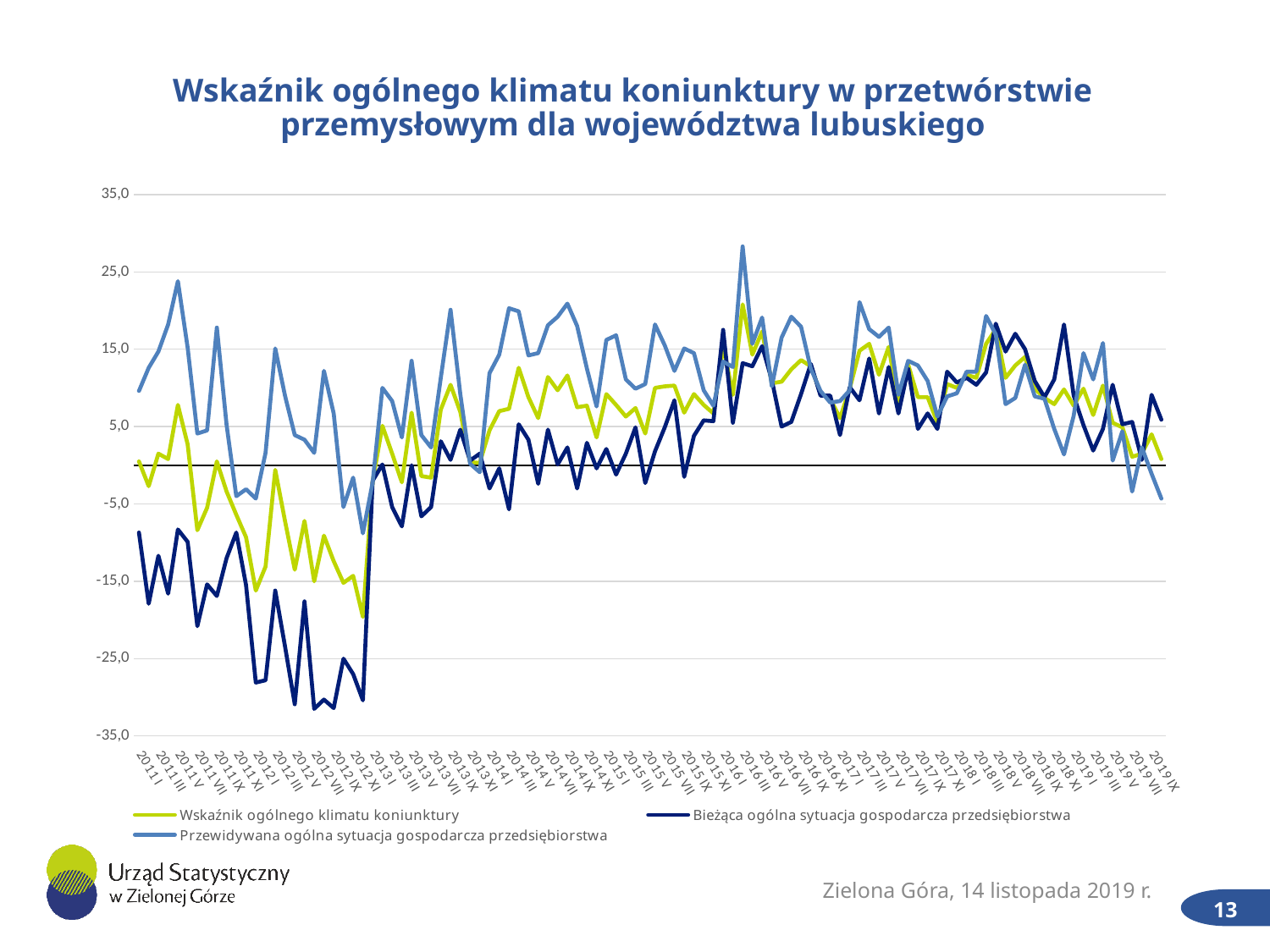
Which series reaches the lowest value anywhere on the chart? Bieżąca ogólna sytuacja gospodarcza przedsiębiorstwa What kind of chart is shown on the slide? line chart Is the value of 'Bieżąca ogólna sytuacja gospodarcza przedsiębiorstwa' at 2012 III greater or less than -25? greater Does 'Bieżąca ogólna sytuacja gospodarcza przedsiębiorstwa' rise or fall between 2012 XI and 2013 I? rise Which series reaches the highest value anywhere on the chart? Przewidywana ogólna sytuacja gospodarcza przedsiębiorstwa At 2012 I, which series has the higher value: 'Przewidywana ogólna sytuacja gospodarcza przedsiębiorstwa' or 'Bieżąca ogólna sytuacja gospodarcza przedsiębiorstwa'? Przewidywana ogólna sytuacja gospodarcza przedsiębiorstwa Which series is drawn in the yellow-green colour? Wskaźnik ogólnego klimatu koniunktury Is the value of 'Przewidywana ogólna sytuacja gospodarcza przedsiębiorstwa' at 2011 I greater or less than 5? greater Is the value of 'Przewidywana ogólna sytuacja gospodarcza przedsiębiorstwa' at 2016 I greater or less than 25? less What is the title of the chart? Wskaźnik ogólnego klimatu koniunktury w przetwórstwie przemysłowym dla województwa lubuskiego How many series does the legend list? 3